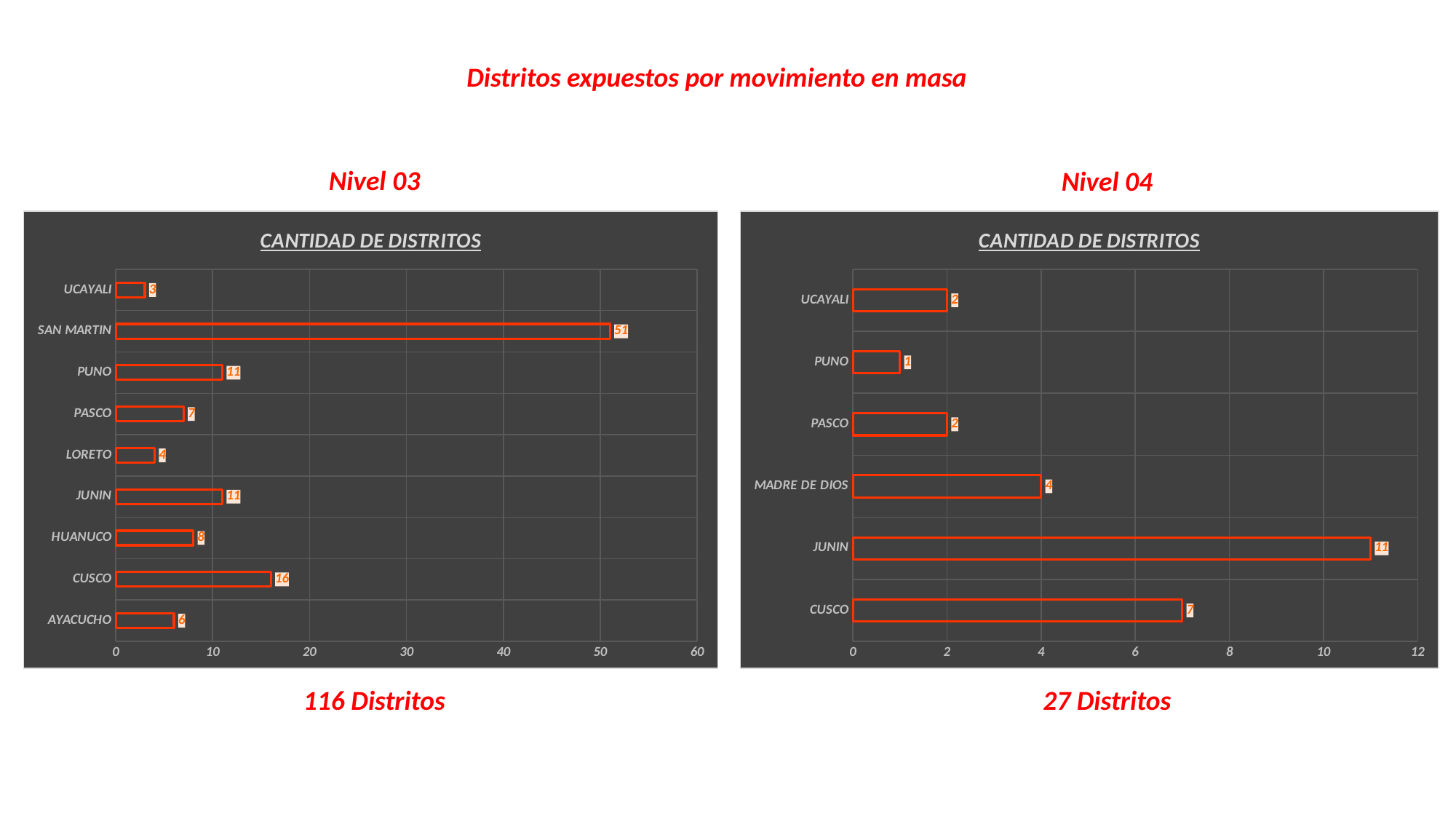
In the Nivel 03 chart, which category has the lowest value? UCAYALI In the Nivel 04 chart, what is the value for MADRE DE DIOS? 4 In the Nivel 04 chart, which category has the lowest value? PUNO In the Nivel 03 chart, what is the difference between the values for CUSCO and HUANUCO? 8 In the Nivel 04 chart, which category has the highest value? JUNIN In the Nivel 04 chart, which is larger, the value for CUSCO or the value for MADRE DE DIOS? CUSCO In the Nivel 03 chart, what is the value for SAN MARTIN? 51 In the Nivel 04 chart, how many categories are shown? 6 In the Nivel 03 chart, which category has the highest value? SAN MARTIN In the Nivel 03 chart, how many categories are shown? 9 In the Nivel 03 chart, is the value for PUNO greater or less than 10? greater What kind of chart is the Nivel 04 chart? Bar chart